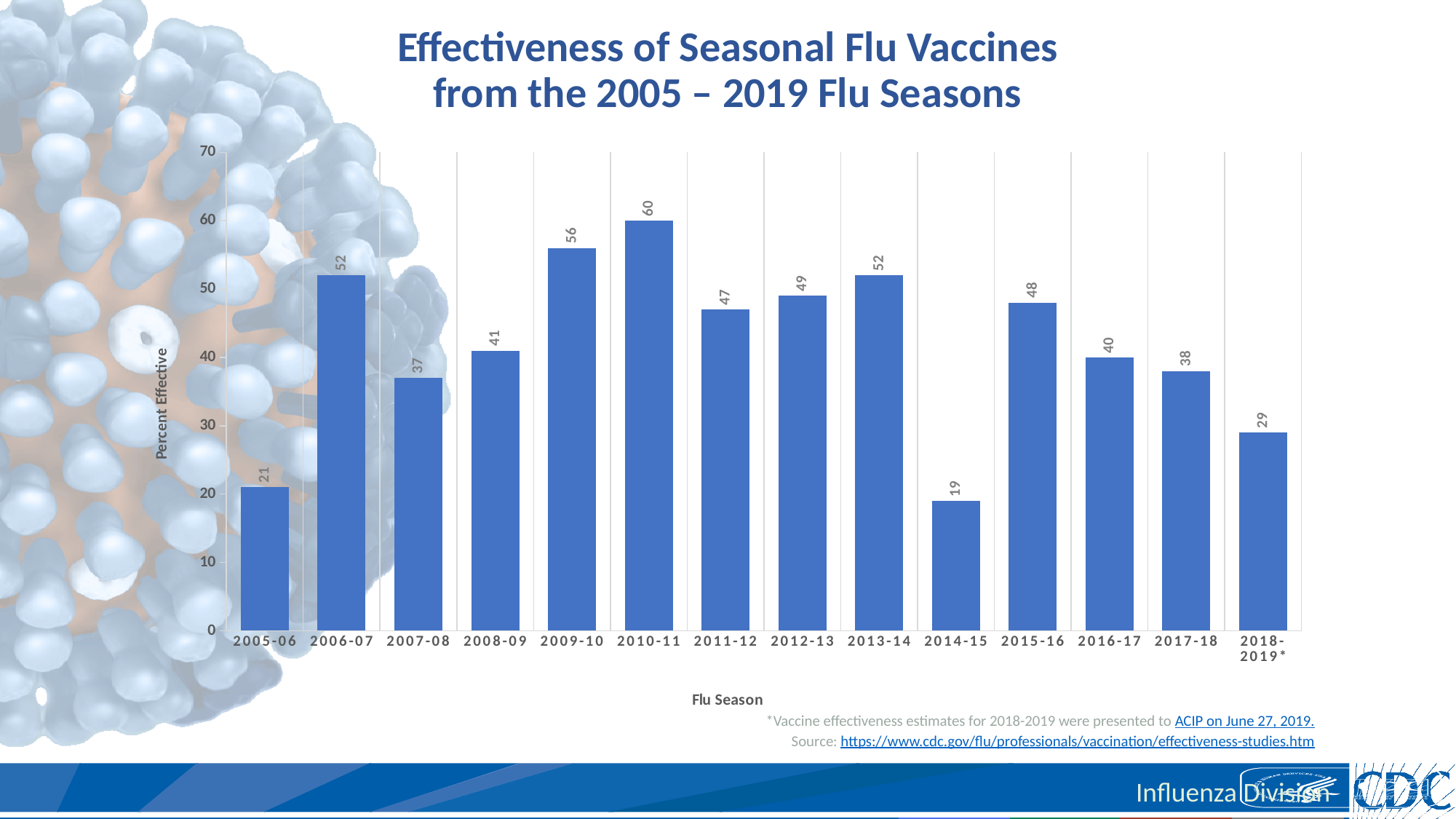
What is the label of the horizontal axis? Flu Season What is the label of the vertical axis? Percent Effective What is the percent effective value for the 2018-2019* flu season? 29 What is the difference in percent effective between the 2010-11 and 2014-15 seasons? 41 What is the percent effective value for the 2010-11 flu season? 60 Is the value for the 2005-06 season greater or less than 30? less Which season had higher vaccine effectiveness, 2009-10 or 2013-14? 2009-10 Which flu season has the lowest vaccine effectiveness? 2014-15 Which flu season has the highest vaccine effectiveness? 2010-11 How many flu seasons are shown on the chart? 14 What kind of chart is shown on the slide? bar chart What is the percent effective value for the 2014-15 flu season? 19